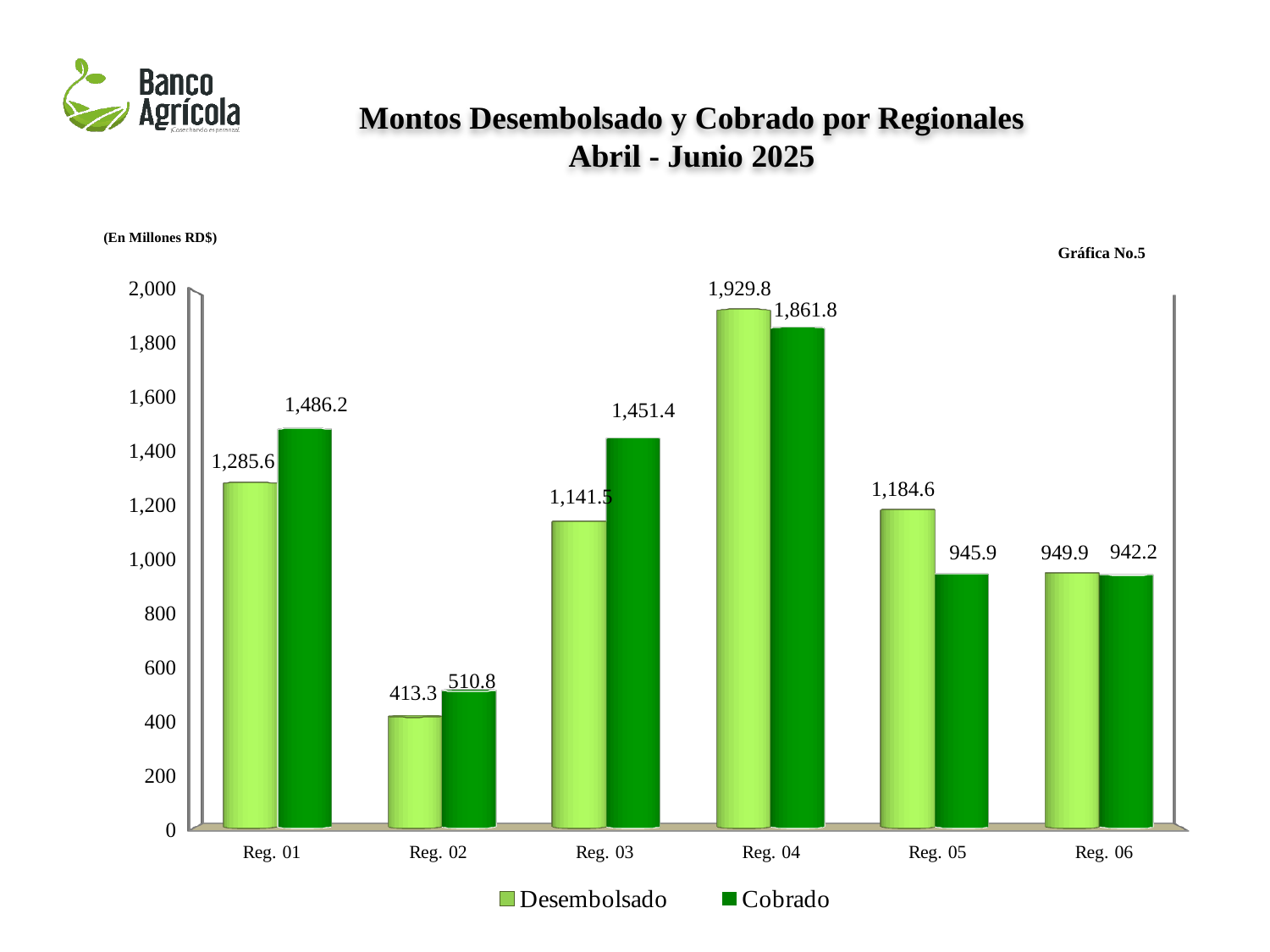
For Reg. 05, which is larger, Desembolsado or Cobrado? Desembolsado Which region has the highest Desembolsado value? Reg. 04 What is the difference between the Cobrado and Desembolsado values for Reg. 02? 97.5 Which region has the lowest Cobrado value? Reg. 02 Is the Cobrado value for Reg. 01 greater or less than 1,400? greater What is the Desembolsado value for Reg. 01? 1,285.6 What unit is stated for the values in the chart? En Millones RD$ What kind of chart is shown on the slide? Bar chart What is the Cobrado value for Reg. 03? 1,451.4 How many series does the legend list? 2 How many regions are shown on the x axis? 6 What is the difference between the Desembolsado and Cobrado values for Reg. 04? 68.0